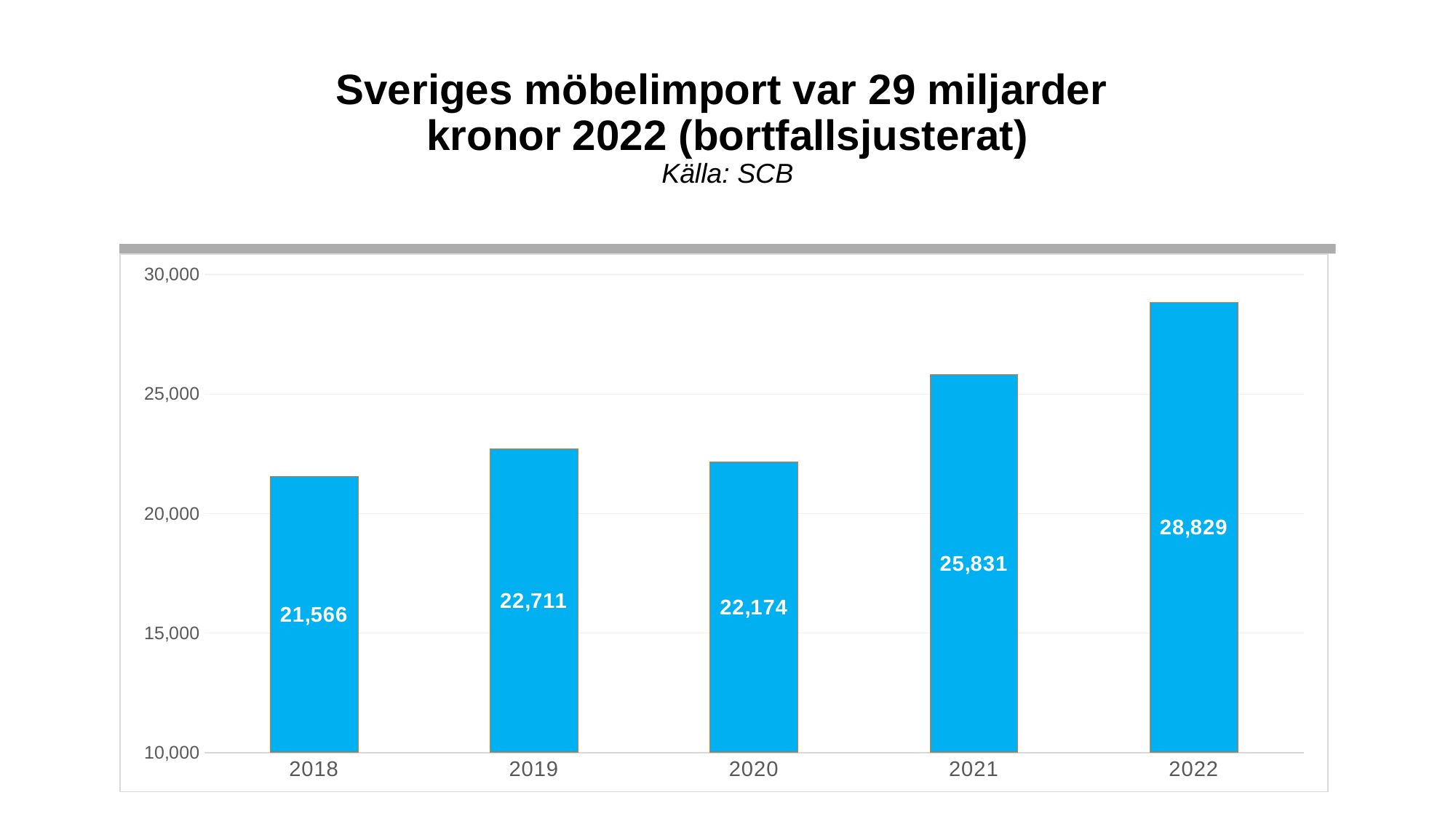
Which year has the highest value? 2022 How many years are shown on the x axis? 5 What is the difference between the values for 2019 and 2020? 537 What is the value for 2018? 21,566 Is the value for 2021 greater or less than 25,000? greater Which year has the lowest value? 2018 What is the difference between the values for 2022 and 2021? 2,998 What is the value for 2022? 28,829 What source is cited below the chart title? SCB What kind of chart is shown on the slide? bar chart Which is larger, the value for 2019 or the value for 2020? 2019 What is the value for 2021? 25,831